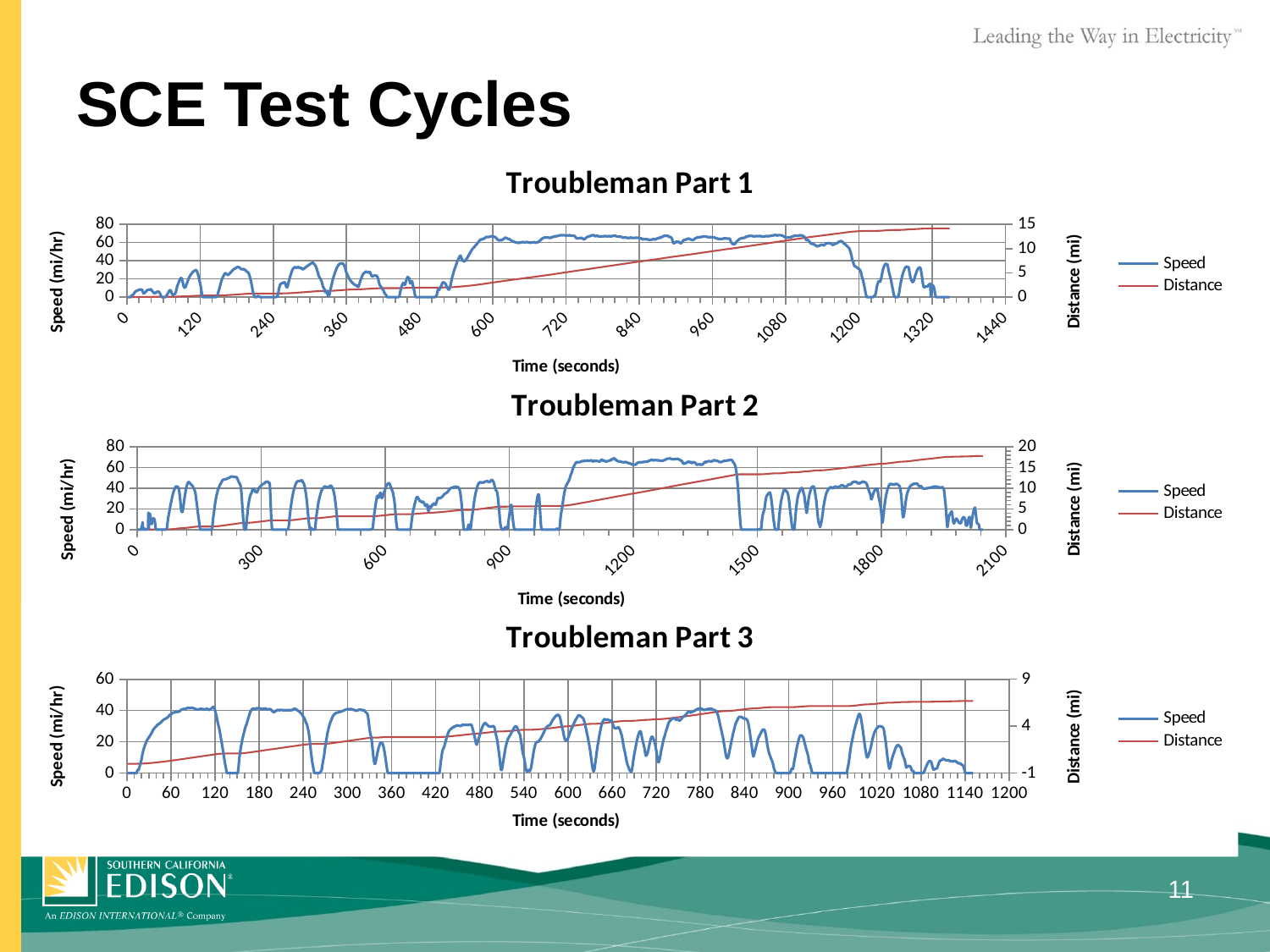
Which chart reaches a higher maximum speed, Troubleman Part 2 or Troubleman Part 3? Troubleman Part 2 What is the x-axis title on the Troubleman Part 2 chart? Time (seconds) In the Troubleman Part 2 chart, is the maximum speed greater or less than 60? greater In the Troubleman Part 3 chart, is the final distance value greater or less than 4? greater In the Troubleman Part 3 chart, is the maximum speed greater or less than 60? less How many series does the legend of the Troubleman Part 2 chart list? 2 In the Troubleman Part 1 chart, does the Distance line rise or fall along the x axis? rise What are the two legend entries on the Troubleman Part 3 chart? Speed and Distance What kind of chart is the Troubleman Part 1 chart? line chart